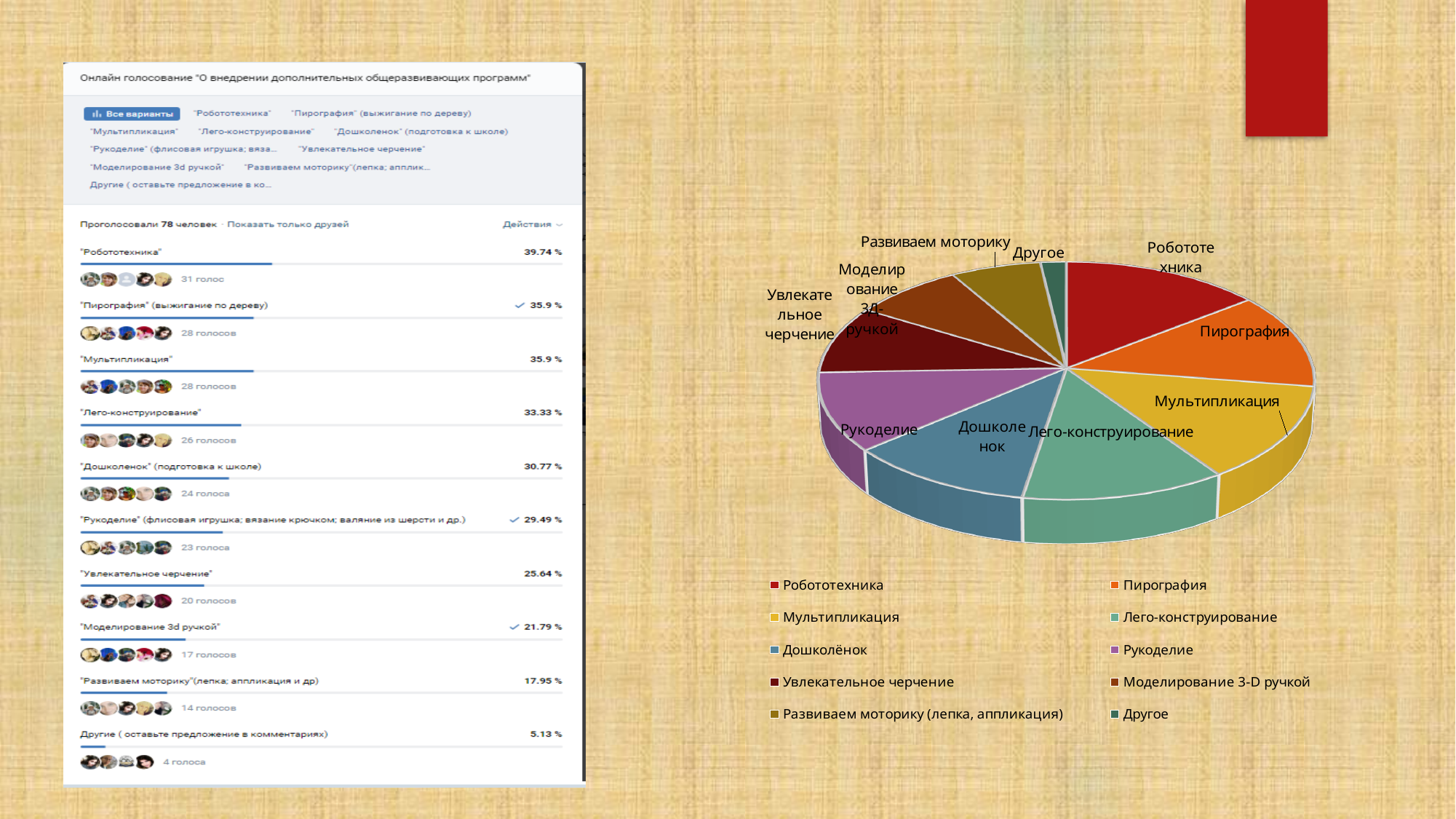
How many slices does the pie chart on the right have? 10 In the poll results screenshot on the left, which option has the highest percentage? Робототехника What colour is the Пирография slice in the pie chart? orange What colour is the Рукоделие slice in the pie chart? purple In the pie chart, which slice is larger: Робототехника or Другое? Робототехника In the pie chart, which category has the smallest slice? Другое In the pie chart, which slice is larger: Развиваем моторику or Другое? Развиваем моторику In the poll results screenshot on the left, what percentage is shown for "Робототехника"? 39.74 % In the pie chart, which slice is larger: Дошколёнок or Развиваем моторику? Дошколёнок What kind of chart is shown on the right side of the slide? pie chart In the poll results screenshot on the left, what percentage is shown for "Другие"? 5.13 % How many entries does the legend below the pie chart list? 10